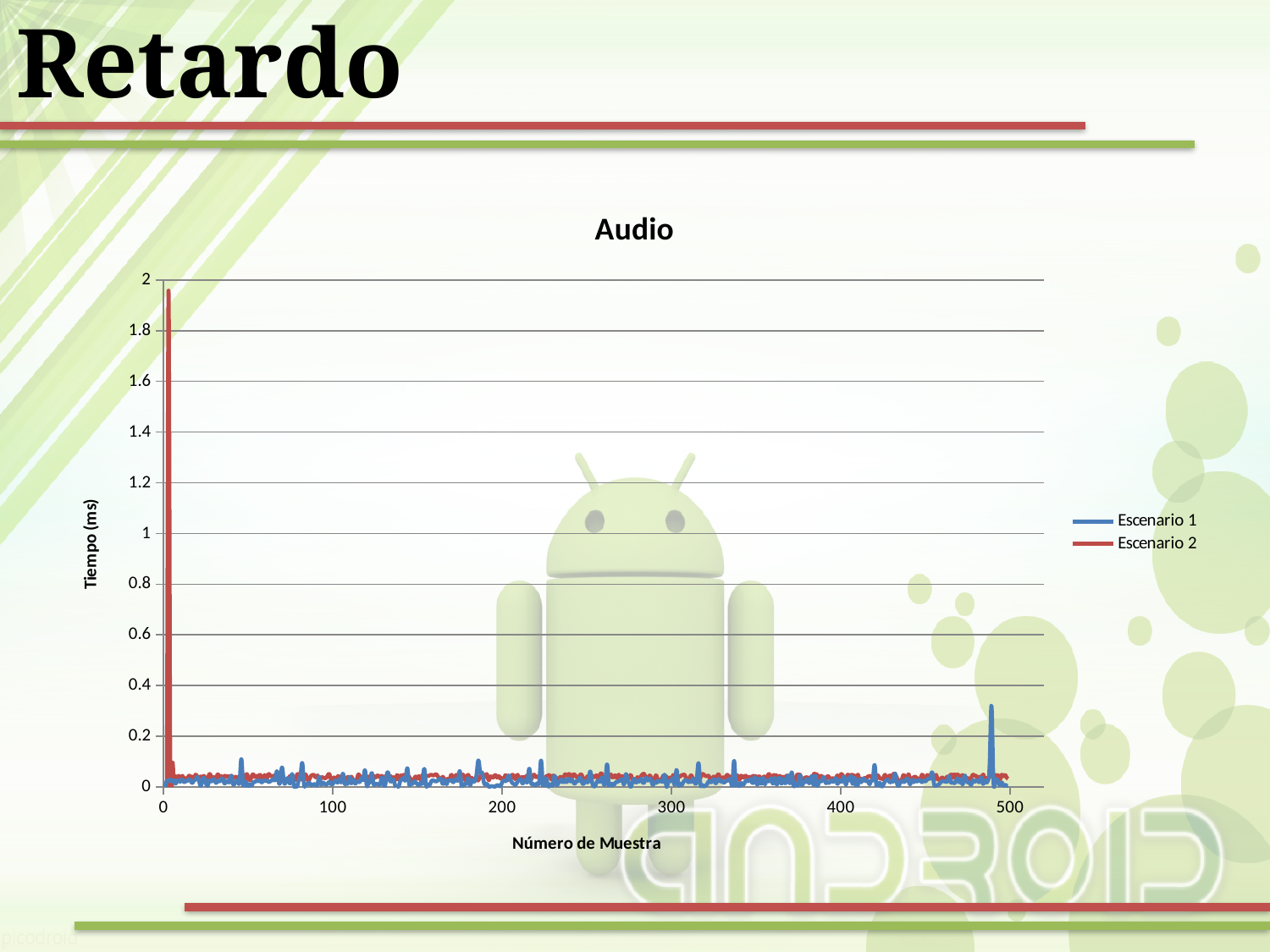
What is the title of the chart? Audio After the initial spike, do the values of Escenario 2 rise, fall, or stay roughly flat along the x axis? Stay roughly flat Is the peak value of Escenario 1 near sample 490 greater or less than 0.4? less What kind of chart is shown on the slide? Line chart Is the peak value of Escenario 2 near sample 0 greater or less than 1.8? greater Which series has the larger peak: Escenario 1 or Escenario 2? Escenario 2 Which series reaches the highest value on the chart? Escenario 2 Is the value for Escenario 1 at sample 300 greater or less than 0.2? less What are the two series named in the legend? Escenario 1 and Escenario 2 How many series does the legend of the Audio chart list? 2